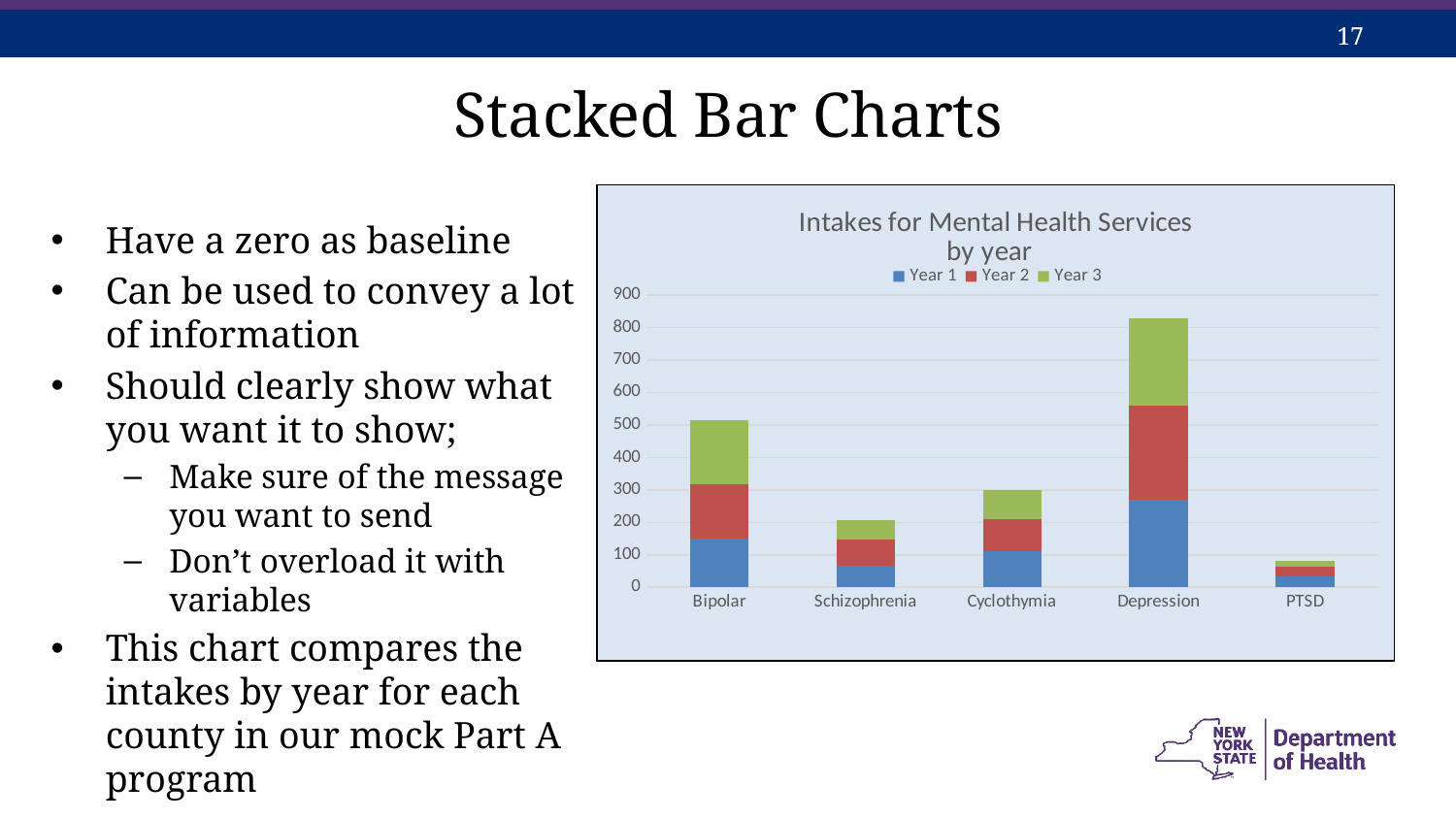
How many categories are shown on the x axis of the chart? 5 Is the total stacked bar for PTSD greater or less than 100? less Is the total stacked bar for Schizophrenia greater or less than 300? less Which category has the lowest total stacked bar? PTSD Which category has the highest total stacked bar? Depression Which has the larger total stacked bar, Bipolar or Cyclothymia? Bipolar What kind of chart is shown on the slide? Stacked bar chart Which colour represents Year 1 in the chart's legend? Blue How many series does the chart's legend list? 3 Is the total stacked bar for Depression greater or less than 700? greater What is the title of the chart? Intakes for Mental Health Services by year